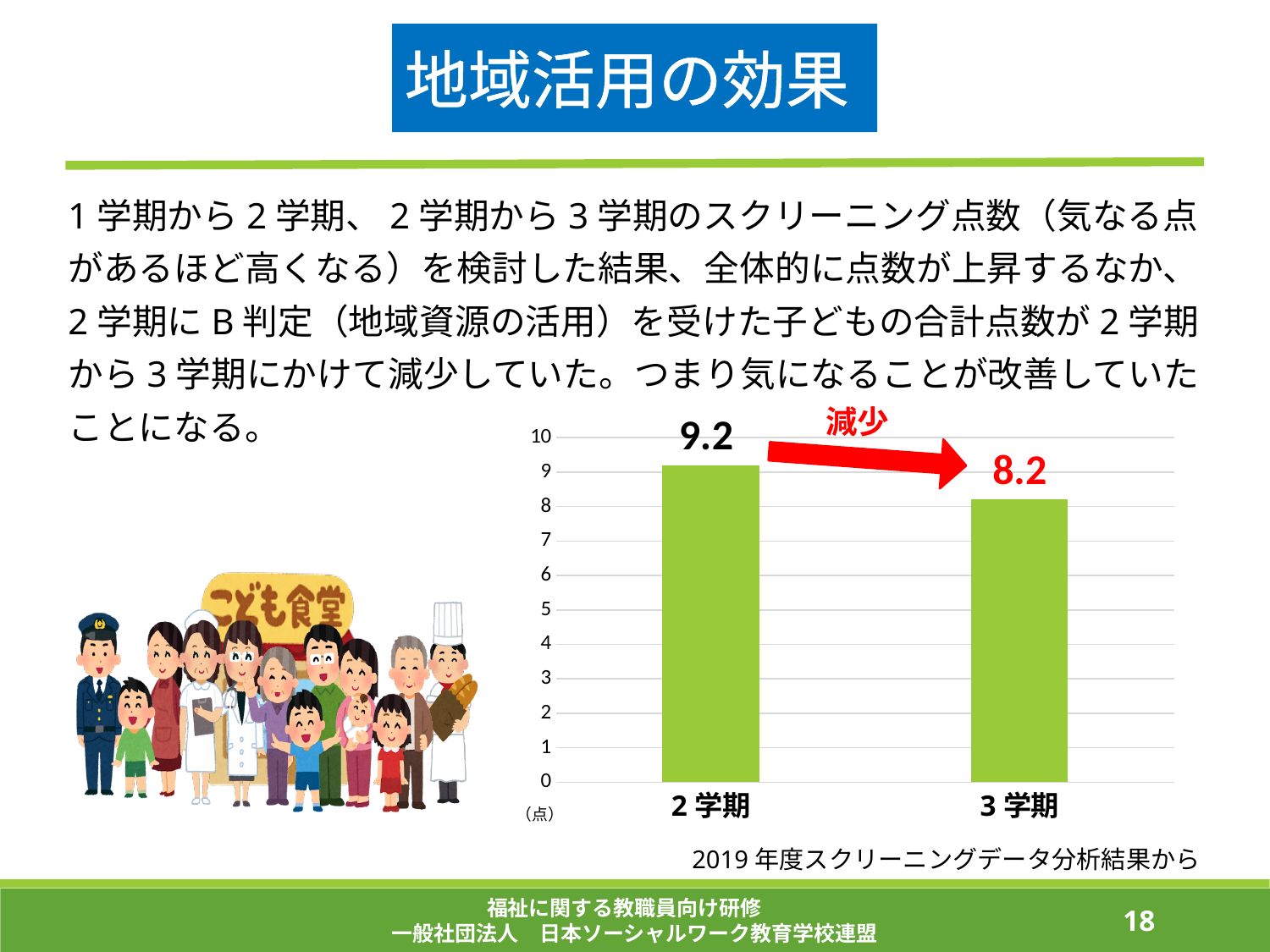
Which category has the lowest value? 3学期 What is the maximum value shown on the y axis? 10 Is the value for 2学期 greater or less than 9? greater Which is larger, the value for 2学期 or the value for 3学期? 2学期 What is the difference between the values for 2学期 and 3学期? 1.0 Do the values rise or fall from 2学期 to 3学期? fall How many categories are shown on the x axis? 2 Which category has the highest value? 2学期 What is the value for 3学期? 8.2 Is the value for 3学期 greater or less than 9? less What is the value for 2学期? 9.2 What kind of chart is shown? bar chart